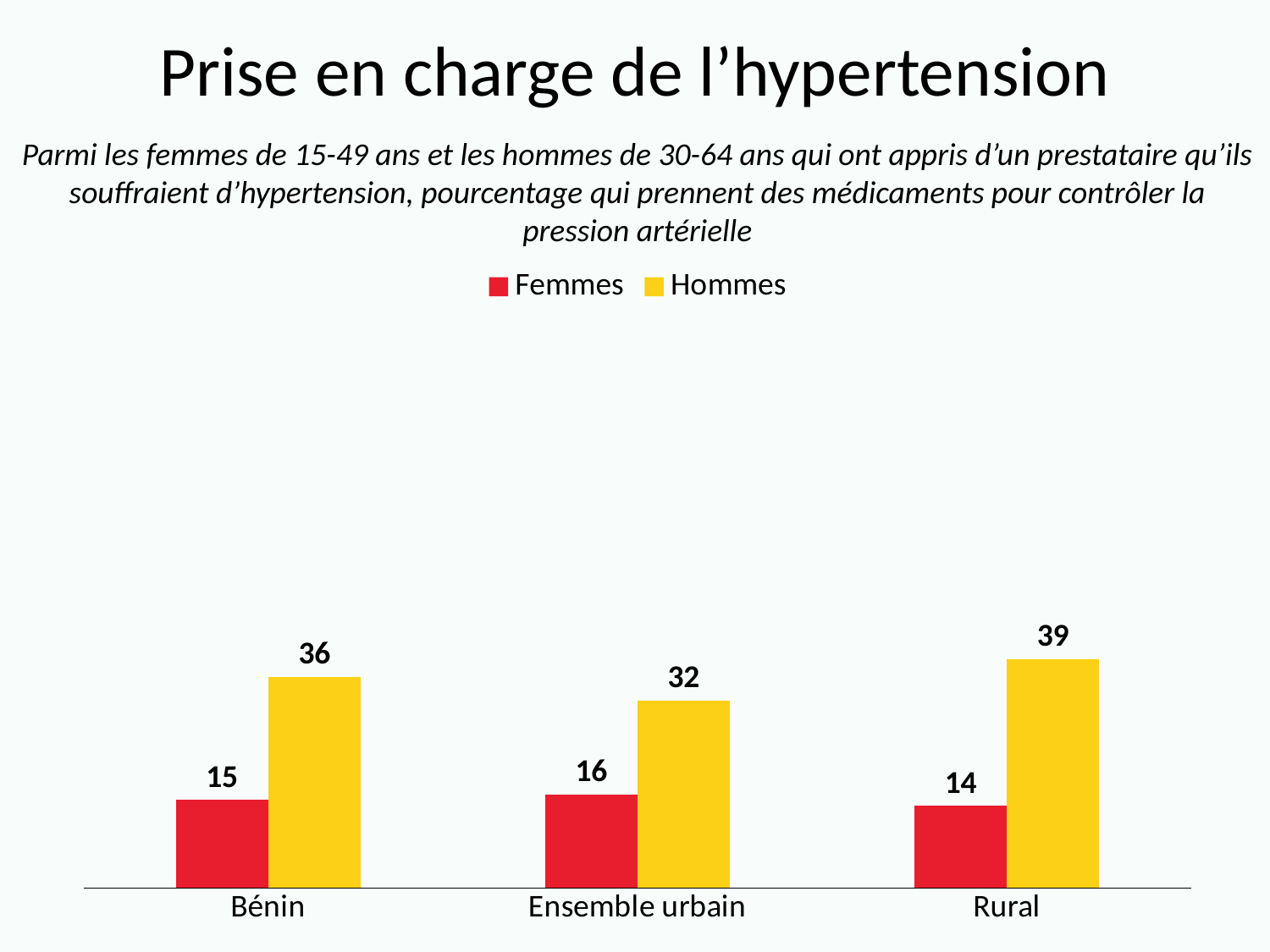
What is the difference between the Hommes and Femmes values in Bénin? 21 Which category has the lowest value for Femmes? Rural What is the value for Hommes in Ensemble urbain? 32 What is the value for Femmes in Rural? 14 Which is larger in Ensemble urbain: the value for Femmes or for Hommes? Hommes What is the value for Femmes in Bénin? 15 Which category has the highest value for Hommes? Rural What is the value for Hommes in Rural? 39 What kind of chart is shown on the slide? Bar chart What colour represents the Hommes series? Yellow How many series does the legend list? 2 How many categories are shown on the x axis? 3